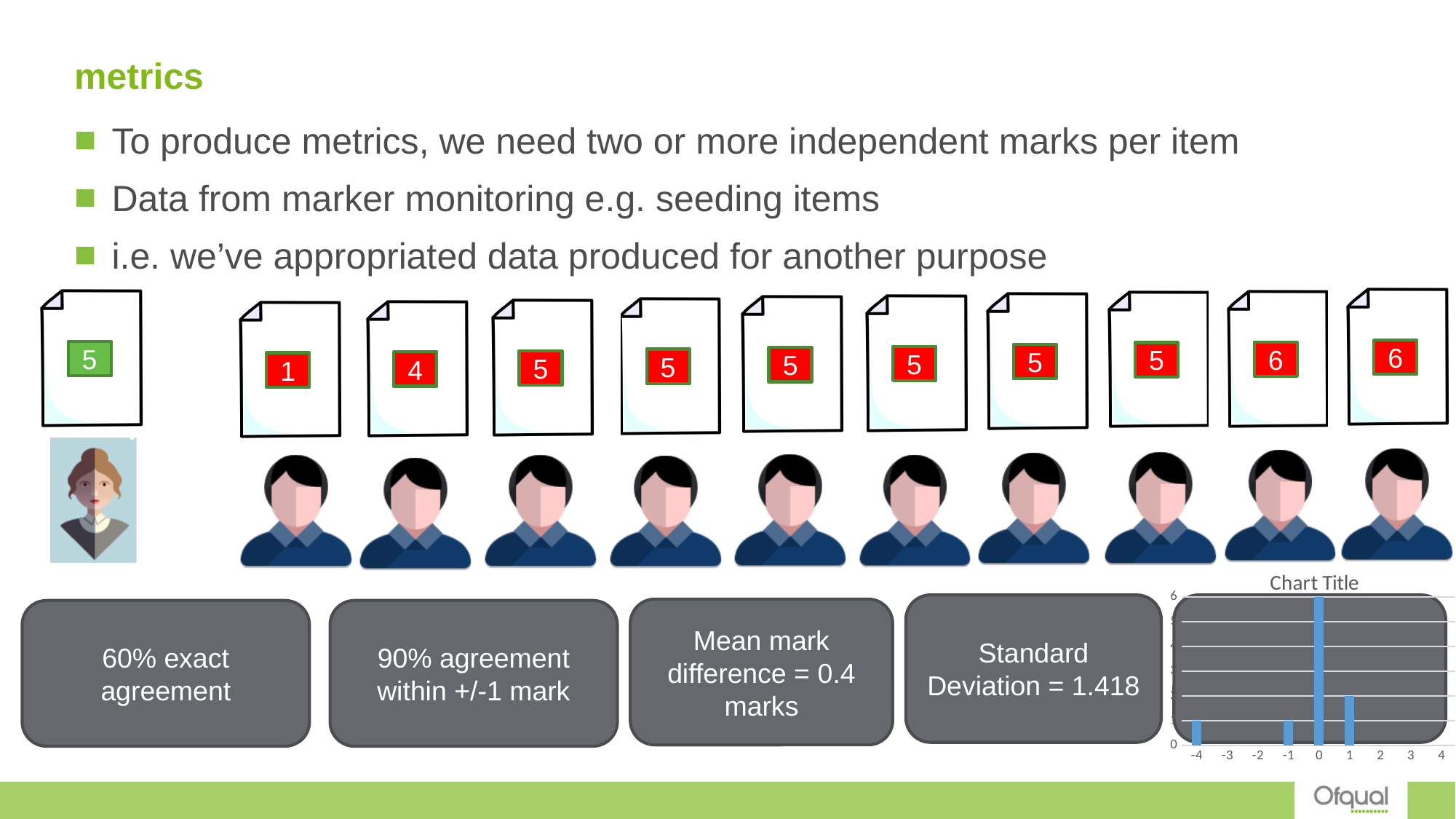
What kind of chart is shown at the bottom right of the slide? bar chart In the chart, is the value for category 1 greater or less than 6? less In the chart, is the bar at category 0 or the bar at category 1 taller? 0 In the chart, is the value for category -1 greater or less than 6? less How many bars are plotted in the chart? 4 In the chart, does the bar at category 2 have any height? No What is the title of the chart at the bottom right of the slide? Chart Title In the chart, what is the value of the bar at x-axis category 0? 6 How many categories are labelled on the x axis of the chart? 9 What is the highest value labelled on the y axis of the chart? 6 In the chart, is the bar at category 1 or the bar at category -4 taller? 1 In the chart, which x-axis category has the tallest bar? 0